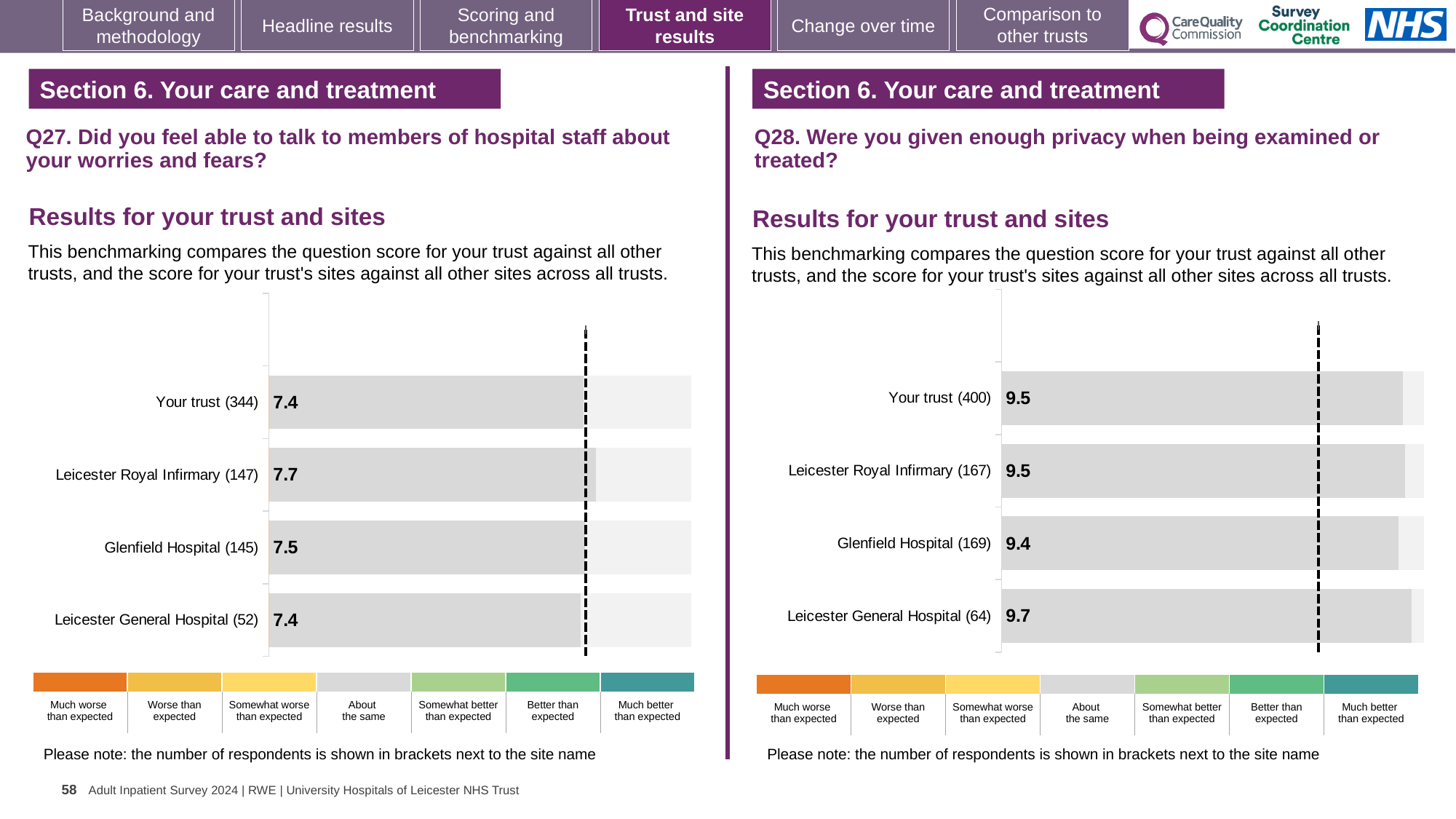
In the Q27 chart (left), what is the score for Leicester Royal Infirmary? 7.7 In the Q28 chart (right), what is the score for Glenfield Hospital? 9.4 What type of chart is used for the Q27 results (left)? Bar chart In the Q28 chart (right), which site has the lowest score? Glenfield Hospital In the Q27 chart (left), what is the difference between the scores for Leicester Royal Infirmary and Glenfield Hospital? 0.2 In the Q27 chart (left), how many bars are plotted? 4 In the Q28 chart (right), what is the score for Leicester General Hospital? 9.7 In the Q28 chart (right), which is larger: the score for Leicester General Hospital or Glenfield Hospital? Leicester General Hospital In the Q27 chart (left), what is the score for Your trust? 7.4 In the Q28 chart (right), what is the difference between the scores for Leicester General Hospital and Your trust? 0.2 In the Q27 chart (left), which site has the highest score? Leicester Royal Infirmary In the Q28 chart (right), how many respondents are shown in brackets for Your trust? 400